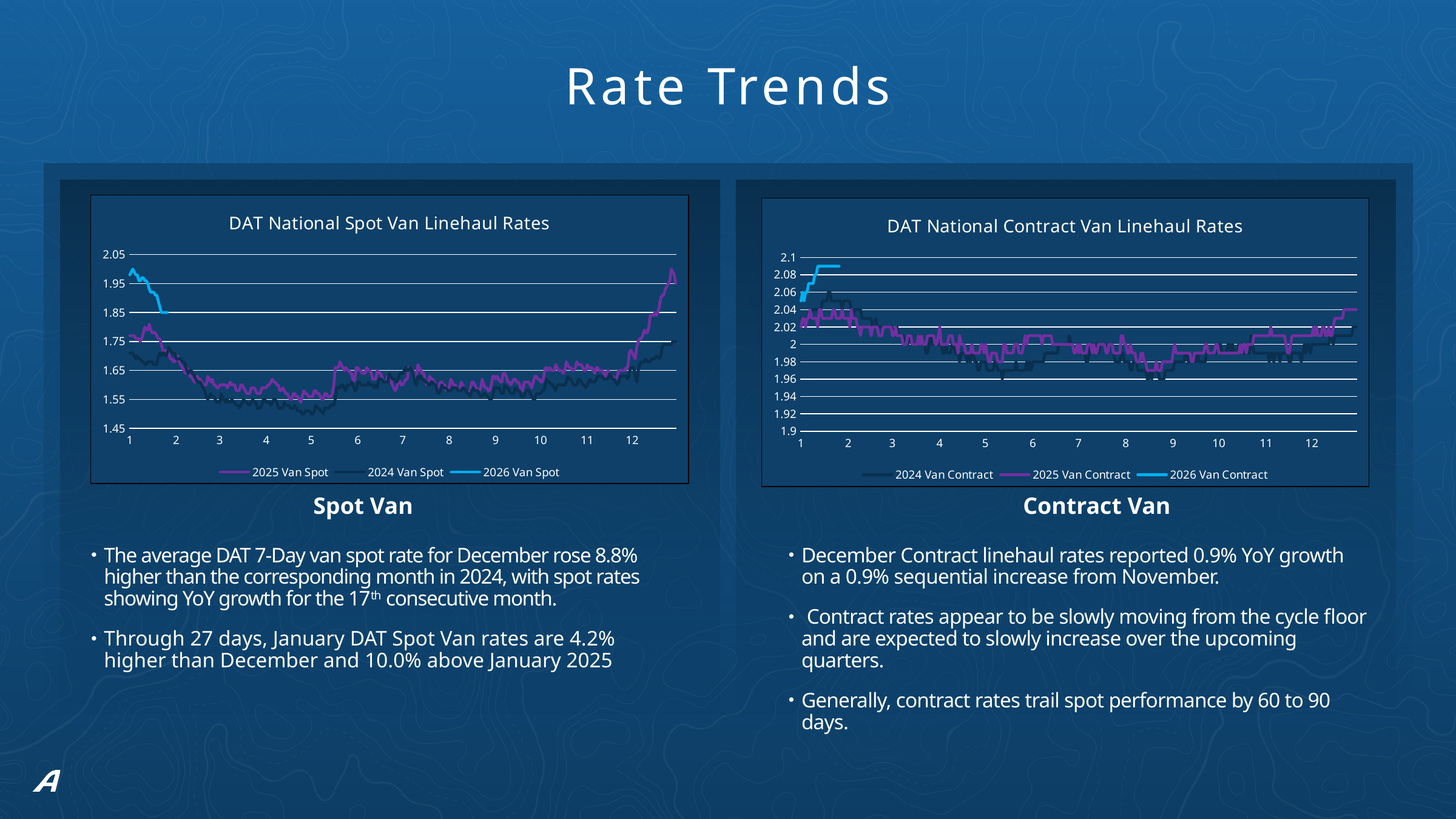
How many series does the legend of the DAT National Contract Van Linehaul Rates chart list? 3 In the DAT National Spot Van Linehaul Rates chart, is the value of the 2026 Van Spot line at month 1 greater or less than 1.95? greater What kind of chart is the DAT National Spot Van Linehaul Rates chart? line chart In the DAT National Spot Van Linehaul Rates chart, is the 2025 Van Spot line at the end of month 12 greater or less than 1.85? greater In the DAT National Spot Van Linehaul Rates chart, is the 2025 Van Spot line at month 5 greater or less than 1.75? less How many months are labelled on the x axis of the DAT National Contract Van Linehaul Rates chart? 12 How many series does the legend of the DAT National Spot Van Linehaul Rates chart list? 3 In the DAT National Spot Van Linehaul Rates chart, which line is higher at month 1: 2026 Van Spot or 2025 Van Spot? 2026 Van Spot In the DAT National Spot Van Linehaul Rates chart, does the 2026 Van Spot line rise or fall over the period shown? fall In the DAT National Contract Van Linehaul Rates chart, does the 2026 Van Contract line rise or fall over the period shown? rise